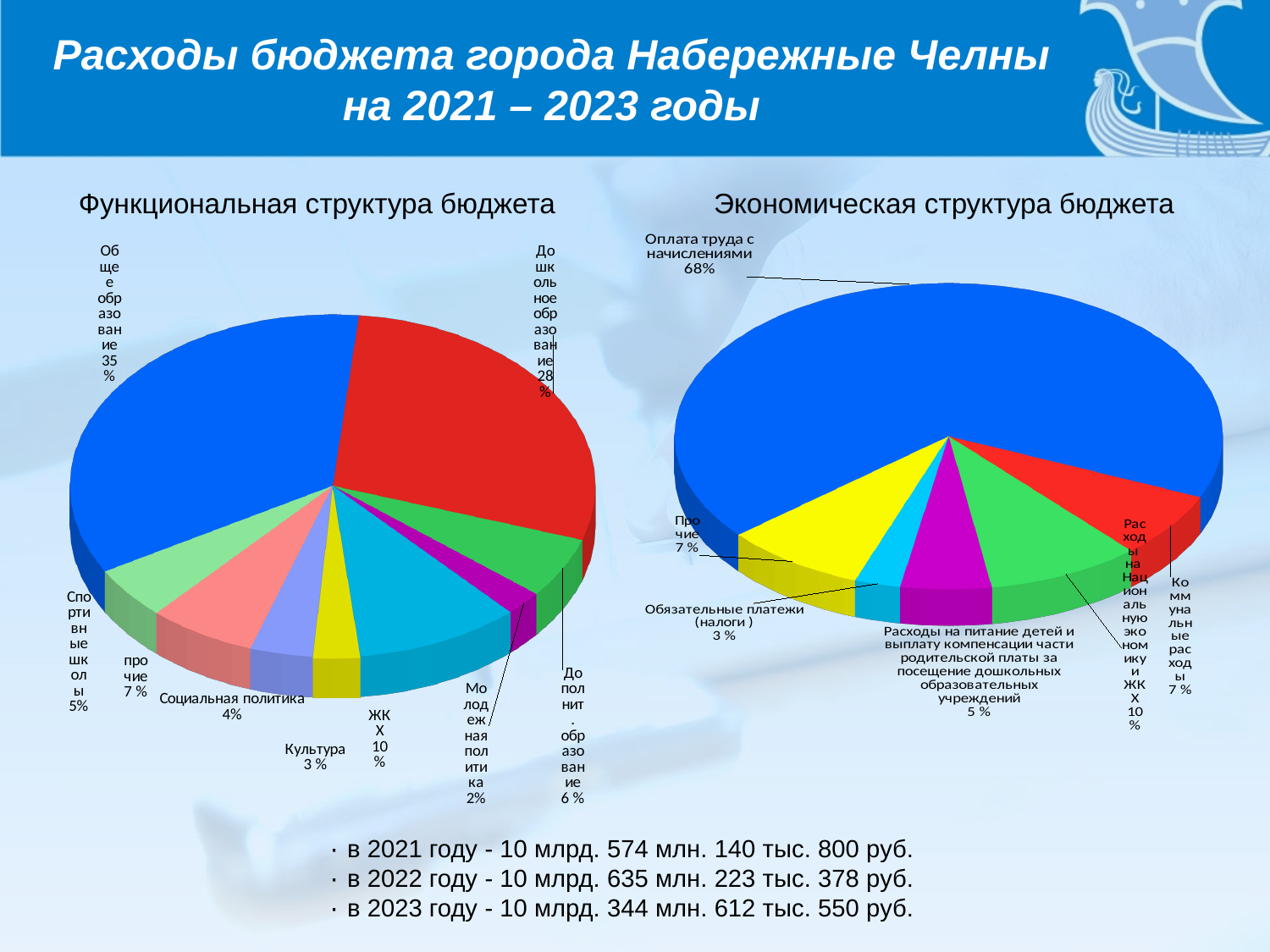
In the chart 'Функциональная структура бюджета', which category has the smallest share? Молодежная политика In the chart 'Функциональная структура бюджета', what share does 'ЖКХ' have? 10 % In the chart 'Функциональная структура бюджета', how many slices does the pie have? 9 In the chart 'Функциональная структура бюджета', what share does 'Общее образование' have? 35% In the chart 'Функциональная структура бюджета', what is the difference in percentage points between 'Общее образование' and 'Дошкольное образование'? 7 What type of chart is 'Экономическая структура бюджета'? Pie chart In the chart 'Экономическая структура бюджета', which is larger: 'Расходы на Национальную экономику и ЖКХ' or 'Коммунальные расходы'? Расходы на Национальную экономику и ЖКХ In the chart 'Функциональная структура бюджета', which category has the largest share? Общее образование In the chart 'Экономическая структура бюджета', how many slices does the pie have? 6 In the chart 'Экономическая структура бюджета', what share does 'Обязательные платежи (налоги)' have? 3 % In the chart 'Экономическая структура бюджета', what share does 'Оплата труда с начислениями' have? 68% In the chart 'Экономическая структура бюджета', what colour is the slice for 'Оплата труда с начислениями'? Blue